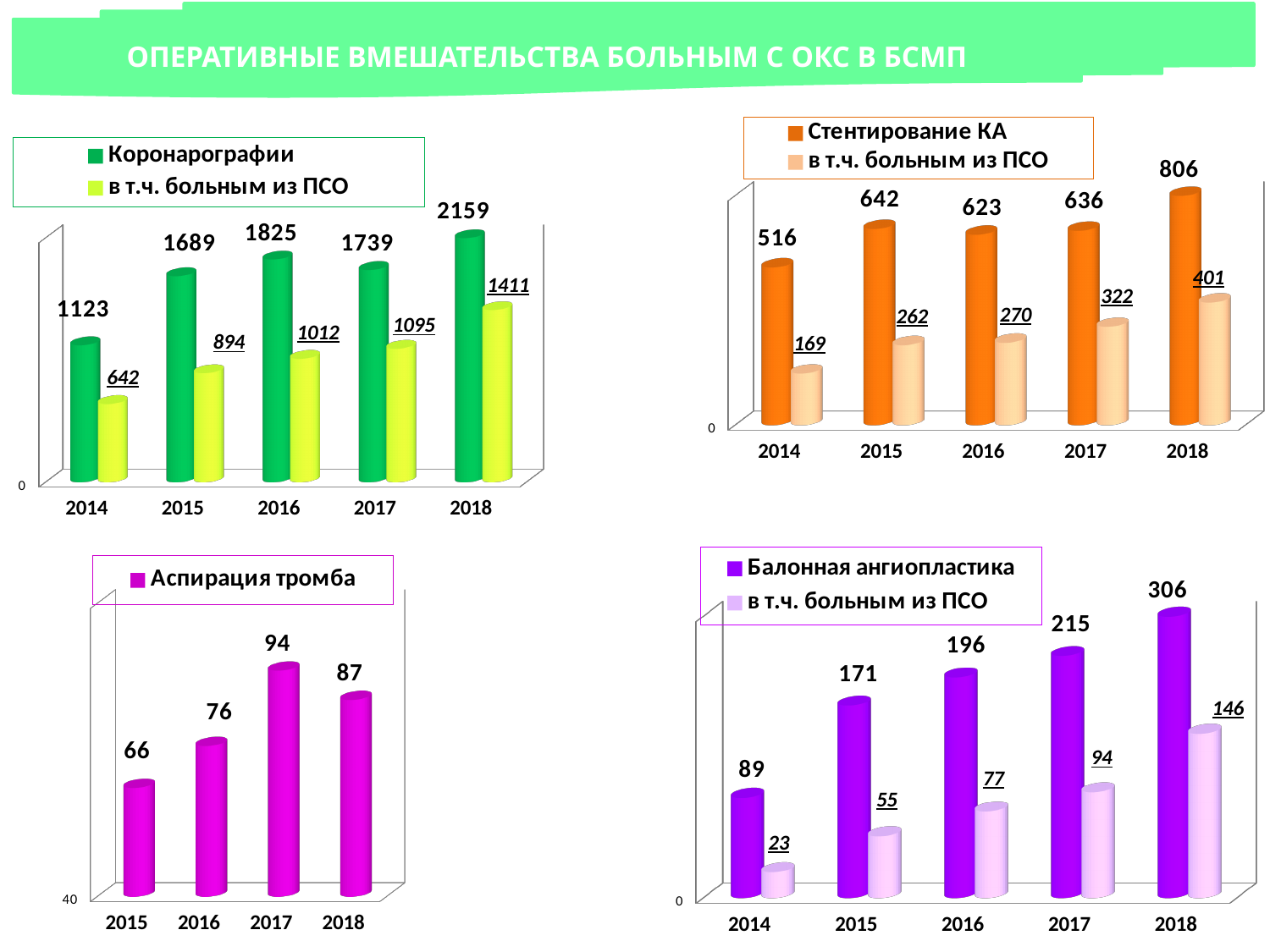
How many series does the legend of the bottom-right chart (Балонная ангиопластика) list? 2 In the top-right chart (Стентирование КА), what is the value for в т.ч. больным из ПСО in 2017? 322 In the bottom-left chart (Аспирация тромба), what is the difference between the values for 2017 and 2018? 7 In the top-left chart (Коронарографии), what is the value for Коронарографии in 2018? 2159 In the bottom-right chart (Балонная ангиопластика), do the values for Балонная ангиопластика rise or fall from 2014 to 2018? rise In the bottom-left chart (Аспирация тромба), how many years are shown on the x axis? 4 In the top-left chart (Коронарографии), what is the value for в т.ч. больным из ПСО in 2016? 1012 In the bottom-right chart (Балонная ангиопластика), what is the value for Балонная ангиопластика in 2017? 215 In the top-right chart (Стентирование КА), which is larger: Стентирование КА in 2015 or in 2016? 2015 In the top-right chart (Стентирование КА), which year has the highest value for Стентирование КА? 2018 In the bottom-left chart (Аспирация тромба), which year has the lowest value? 2015 In the top-left chart (Коронарографии), what is the difference between Коронарографии and в т.ч. больным из ПСО in 2014? 481